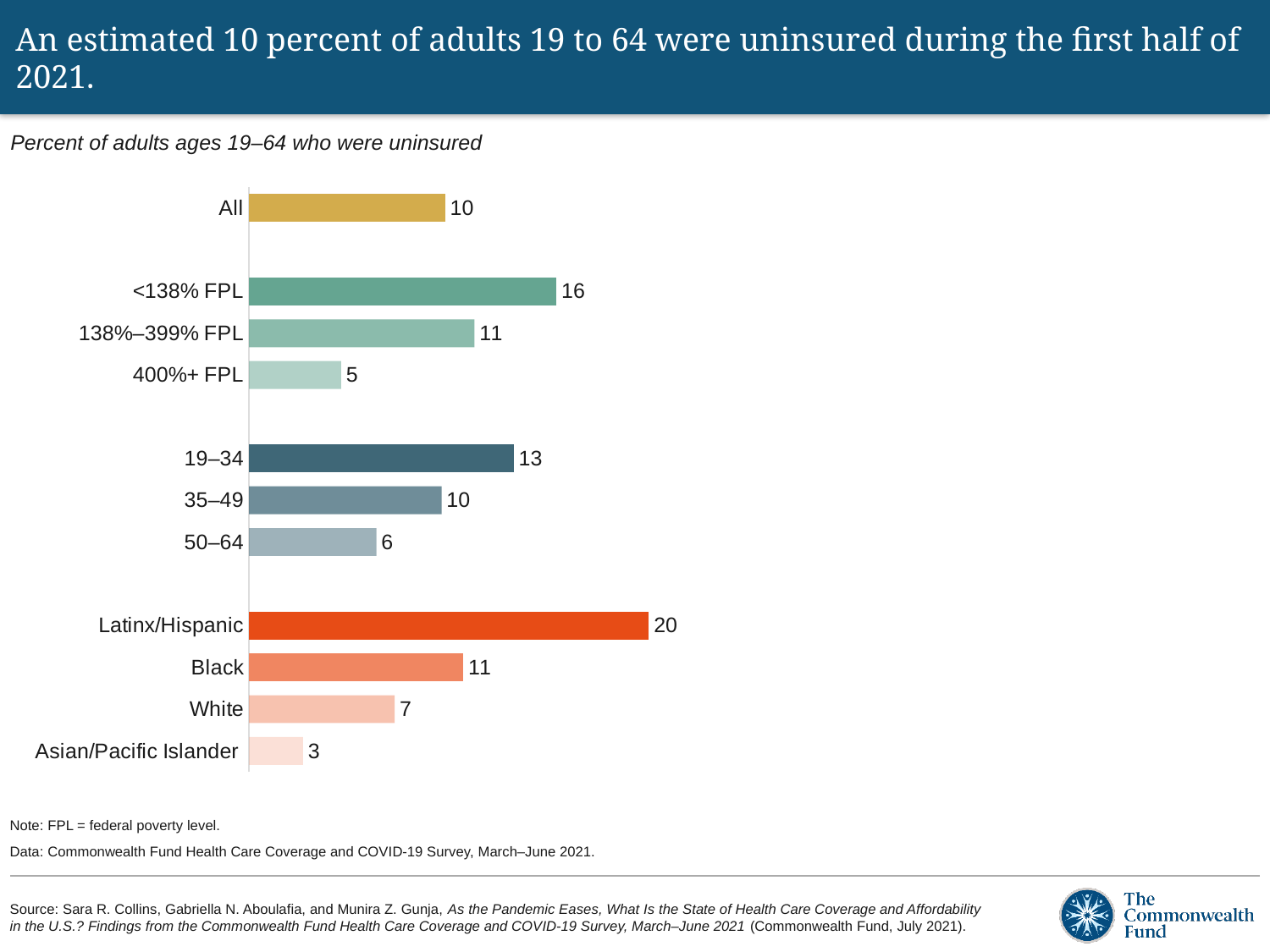
What is the value for 400%+ FPL? 5 What is the difference between the values for Latinx/Hispanic and White? 13 What kind of chart is shown on the slide? Bar chart How many categories are shown in the chart? 11 Which category has the highest value? Latinx/Hispanic Which is larger, the value for Black or the value for 50–64? Black What is the difference between the values for <138% FPL and 400%+ FPL? 11 Which category has the lowest value? Asian/Pacific Islander What is the value for All adults? 10 What is the subtitle of the chart? Percent of adults ages 19–64 who were uninsured What is the value for Latinx/Hispanic? 20 What is the value for the 19–34 age group? 13